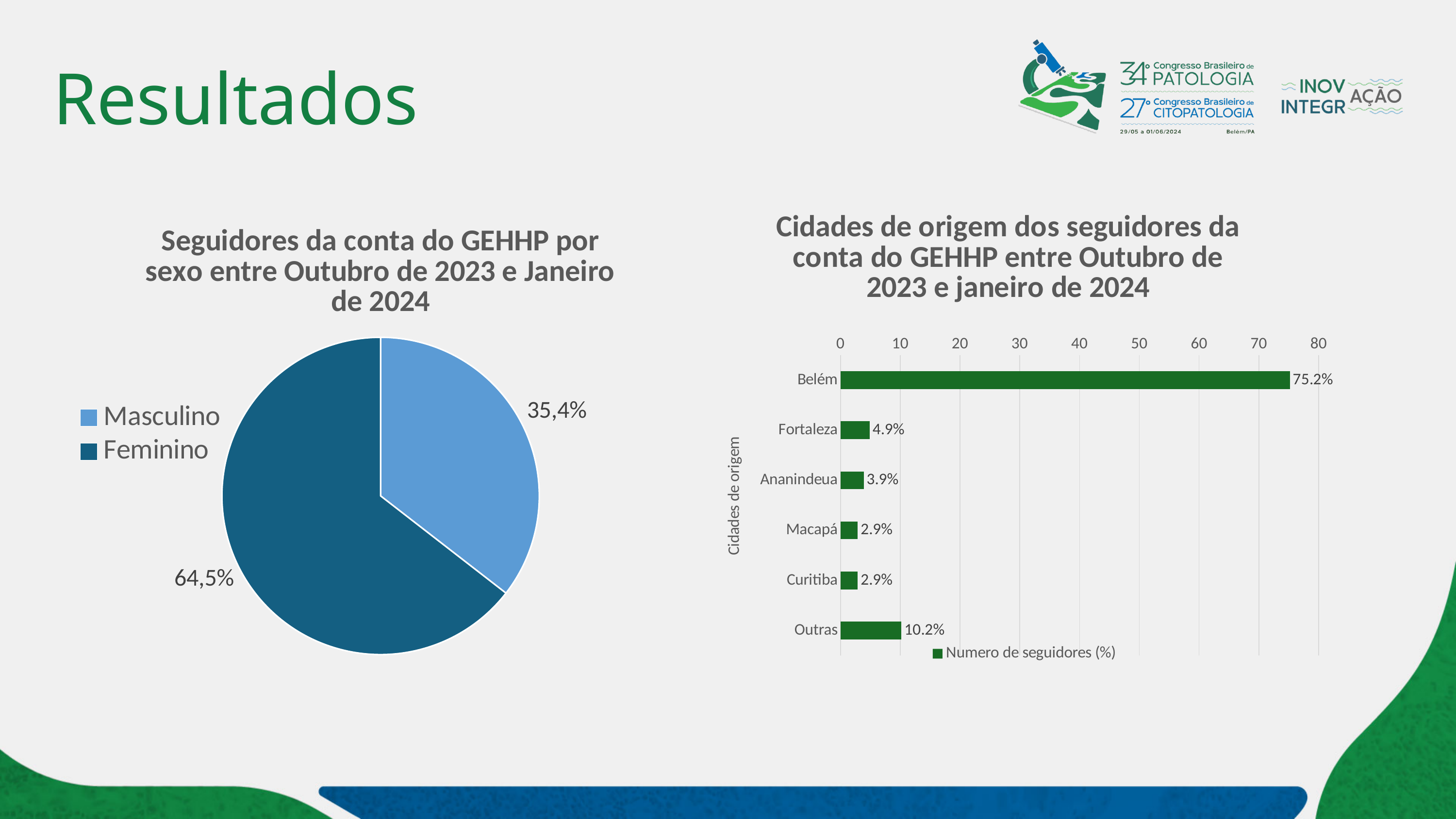
In the bar chart on the right, which city has the highest value? Belém In the bar chart on the right, what is the value for Outras? 10.2% In the bar chart on the right, which is larger, the value for Fortaleza or the value for Ananindeua? Fortaleza In the pie chart on the left, which category has the larger share, Masculino or Feminino? Feminino In the bar chart on the right, how many cities of origin are plotted? 6 In the pie chart on the left, what percentage of followers are Feminino? 64,5% What kind of chart is the chart on the left? Pie chart In the bar chart on the right, what is the difference between the values for Belém and Fortaleza? 70.3% What kind of chart is the chart on the right? Bar chart In the pie chart on the left, what percentage of followers are Masculino? 35,4% In the bar chart on the right, what is the value for Belém? 75.2% In the pie chart on the left, how many categories does the legend list? 2